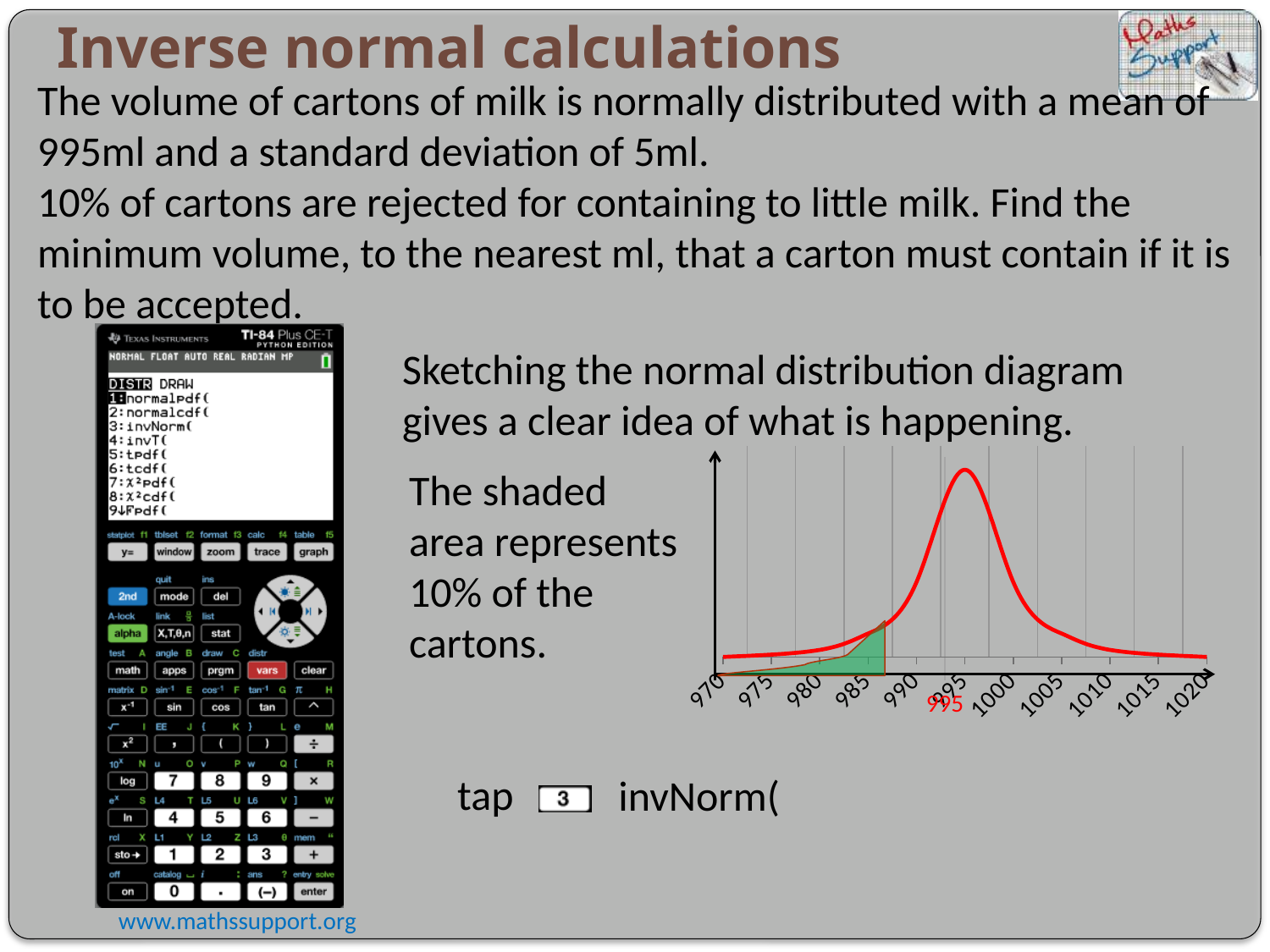
What is the highest value labelled on the x axis of the normal distribution diagram? 1020 What percentage of the cartons does the shaded area of the diagram represent? 10% What kind of chart is the diagram on the right of the slide? A line chart (normal distribution curve) How many labelled tick values are shown on the x axis of the normal distribution diagram? 11 Does the curve rise or fall as x increases from 970 to 995? Rise What is the lowest value labelled on the x axis of the normal distribution diagram? 970 At which x-axis value does the normal distribution curve reach its peak? 995 Does the curve rise or fall as x increases from 995 to 1020? Fall Is the height of the curve at 995 greater or less than its height at 1010? Greater What is the spacing between consecutive labelled ticks on the x axis of the diagram? 5 Is the shaded area of the diagram located to the left or to the right of the peak of the curve? Left Is the right-hand edge of the shaded region greater or less than 990 on the x axis? Less